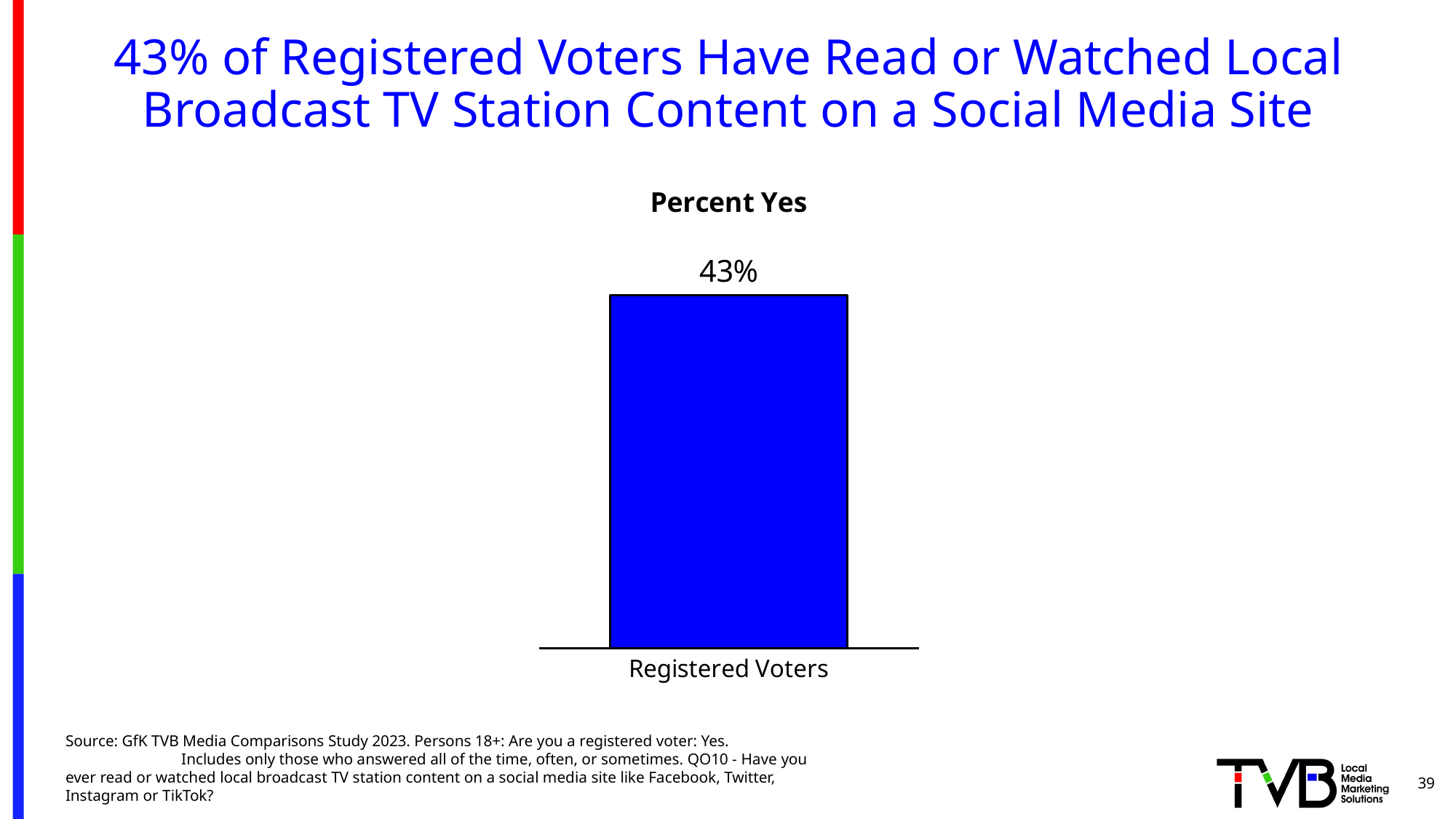
What is the category label on the x axis of the chart? Registered Voters What is the value shown for Registered Voters? 43% What kind of chart is shown on the slide? bar chart Is the value for Registered Voters greater or less than 50%? less How many bars are plotted in the chart? 1 What is the title of the chart? Percent Yes